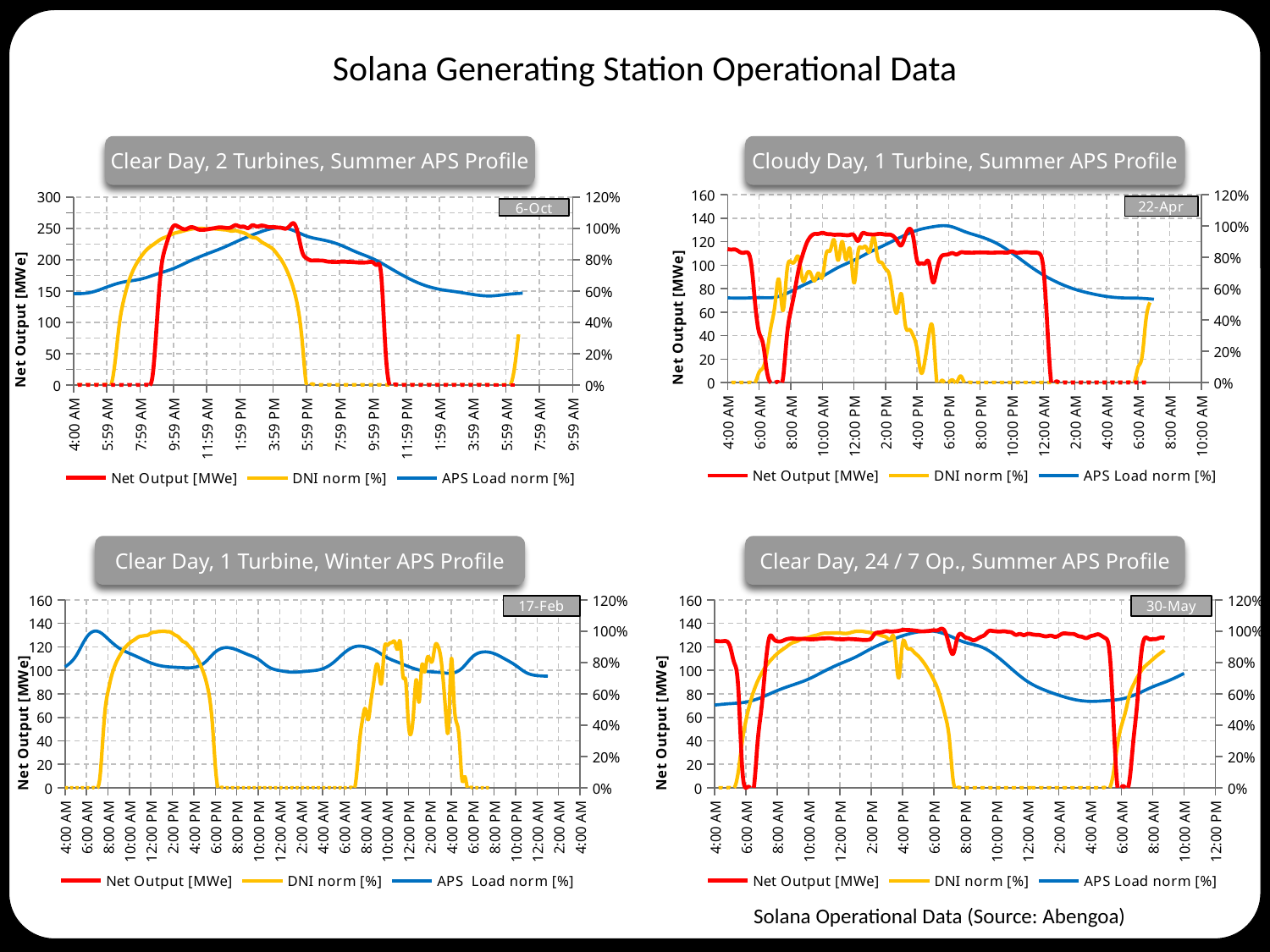
In the 'Clear Day, 2 Turbines, Summer APS Profile' chart, does the APS Load norm rise or fall between 5:59 PM and 11:59 PM? fall In the 'Clear Day, 24 / 7 Op., Summer APS Profile' chart, is the Net Output at 12:00 PM greater or less than 100 MWe? greater What date label is shown on the 'Clear Day, 24 / 7 Op., Summer APS Profile' chart? 30-May In the 'Clear Day, 2 Turbines, Summer APS Profile' chart, is the peak Net Output greater or less than 200 MWe? greater In the 'Clear Day, 24 / 7 Op., Summer APS Profile' chart, is the Net Output higher at 12:00 PM or at 6:00 AM on the first day? 12:00 PM In the 'Clear Day, 1 Turbine, Winter APS Profile' chart, is the peak DNI norm greater or less than 80%? greater How many series does the legend of the 'Cloudy Day, 1 Turbine, Summer APS Profile' chart list? 3 What date label is shown on the 'Clear Day, 2 Turbines, Summer APS Profile' chart? 6-Oct In the 'Clear Day, 2 Turbines, Summer APS Profile' chart, does the APS Load norm rise or fall between 4:00 AM and 3:59 PM? rise What kind of chart is the 'Clear Day, 2 Turbines, Summer APS Profile' chart? line chart How many charts are shown on the slide? 4